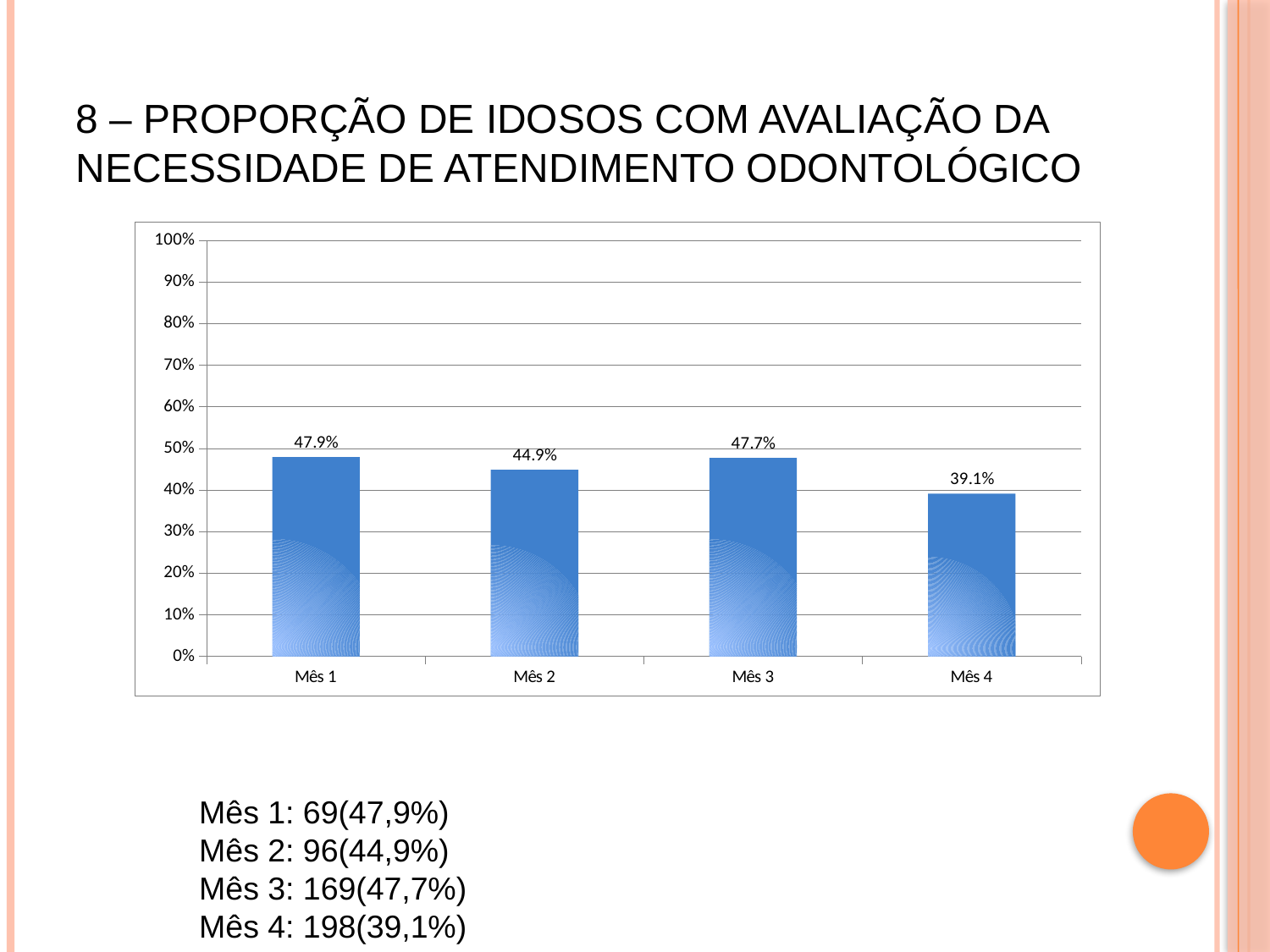
What is the difference between the values for Mês 1 and Mês 2? 3.0 percentage points What is the value for Mês 2? 44.9% How many months are shown on the x axis? 4 What kind of chart is shown on the slide? Bar chart What is the difference between the values for Mês 1 and Mês 4? 8.8 percentage points What is the value for Mês 1? 47.9% Is the value for Mês 4 greater or less than 40%? less Which month has the lowest value? Mês 4 What is the value for Mês 4? 39.1% Which month has the highest value? Mês 1 What is the value for Mês 3? 47.7% Which is larger, the value for Mês 2 or the value for Mês 4? Mês 2